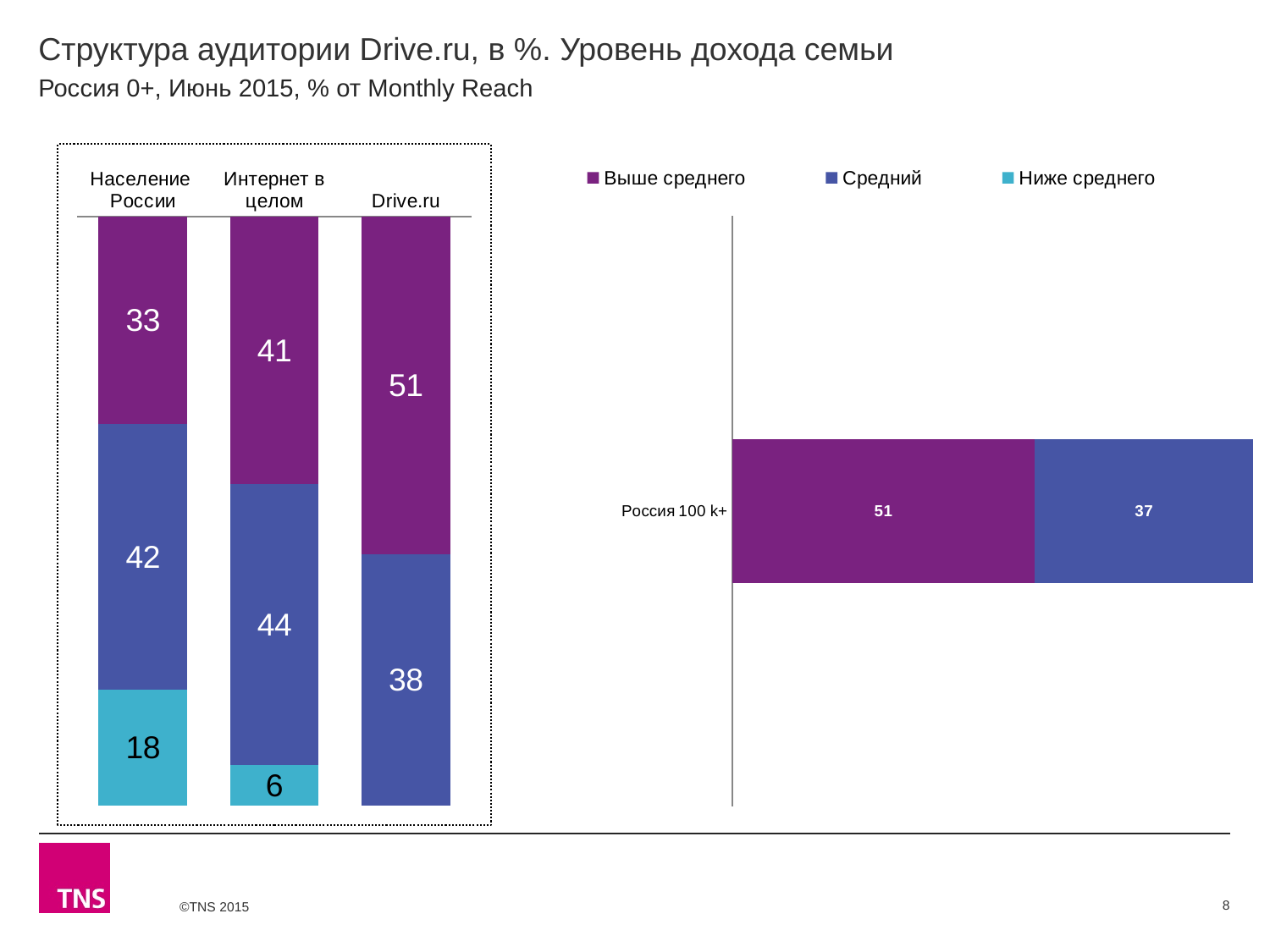
In the left chart, which category has the highest Выше среднего value? Drive.ru In the left chart, what is the value of the Ниже среднего segment for Население России? 18 How many categories are shown on the x axis of the left chart? 3 In the left chart, what is the value of the Средний segment for Интернет в целом? 44 In the right chart, what is the Средний value for Россия 100 k+? 37 In the left chart, what is the value of the Выше среднего segment for Drive.ru? 51 What kind of chart is the left chart? Stacked bar chart How many series does the legend list? 3 In the left chart, what is the difference between the Выше среднего values for Drive.ru and Население России? 18 In the left chart, which is larger: the Средний value for Население России or for Drive.ru? Население России In the right chart, what is the total of the Россия 100 k+ bar? 88